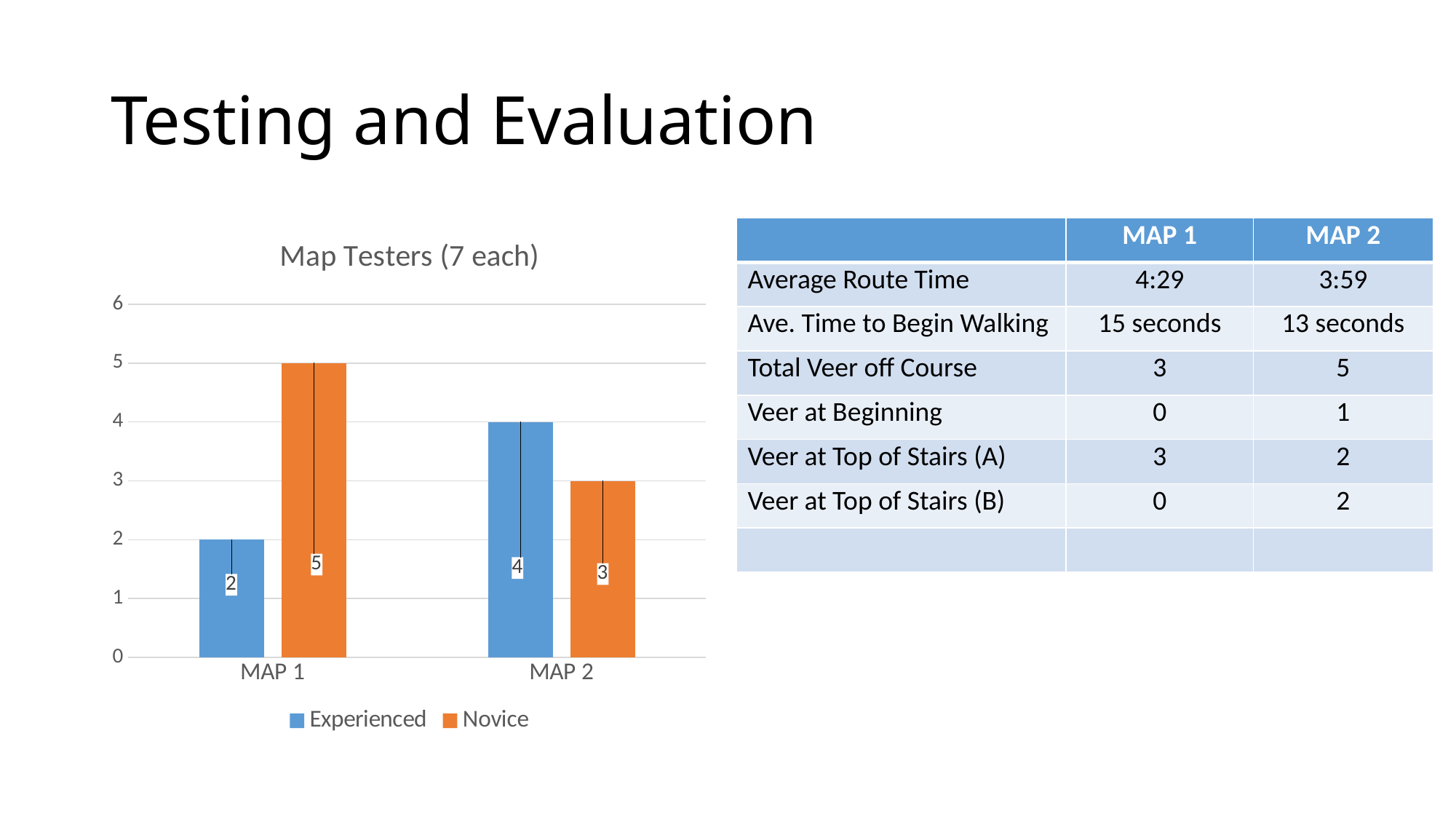
What is the difference between the Novice and Experienced values for MAP 1? 3 What is the title of the chart? Map Testers (7 each) What is the value for Experienced testers on MAP 2? 4 Which is larger on MAP 2, the Experienced value or the Novice value? Experienced Which bar in the chart has the lowest value? Experienced, MAP 1 How many series does the chart legend list? 2 What is the value for Novice testers on MAP 2? 3 What is the value for Experienced testers on MAP 1? 2 How many categories are shown on the x axis of the chart? 2 What is the value for Novice testers on MAP 1? 5 Which bar in the chart has the highest value? Novice, MAP 1 What kind of chart is shown on the slide? Bar chart